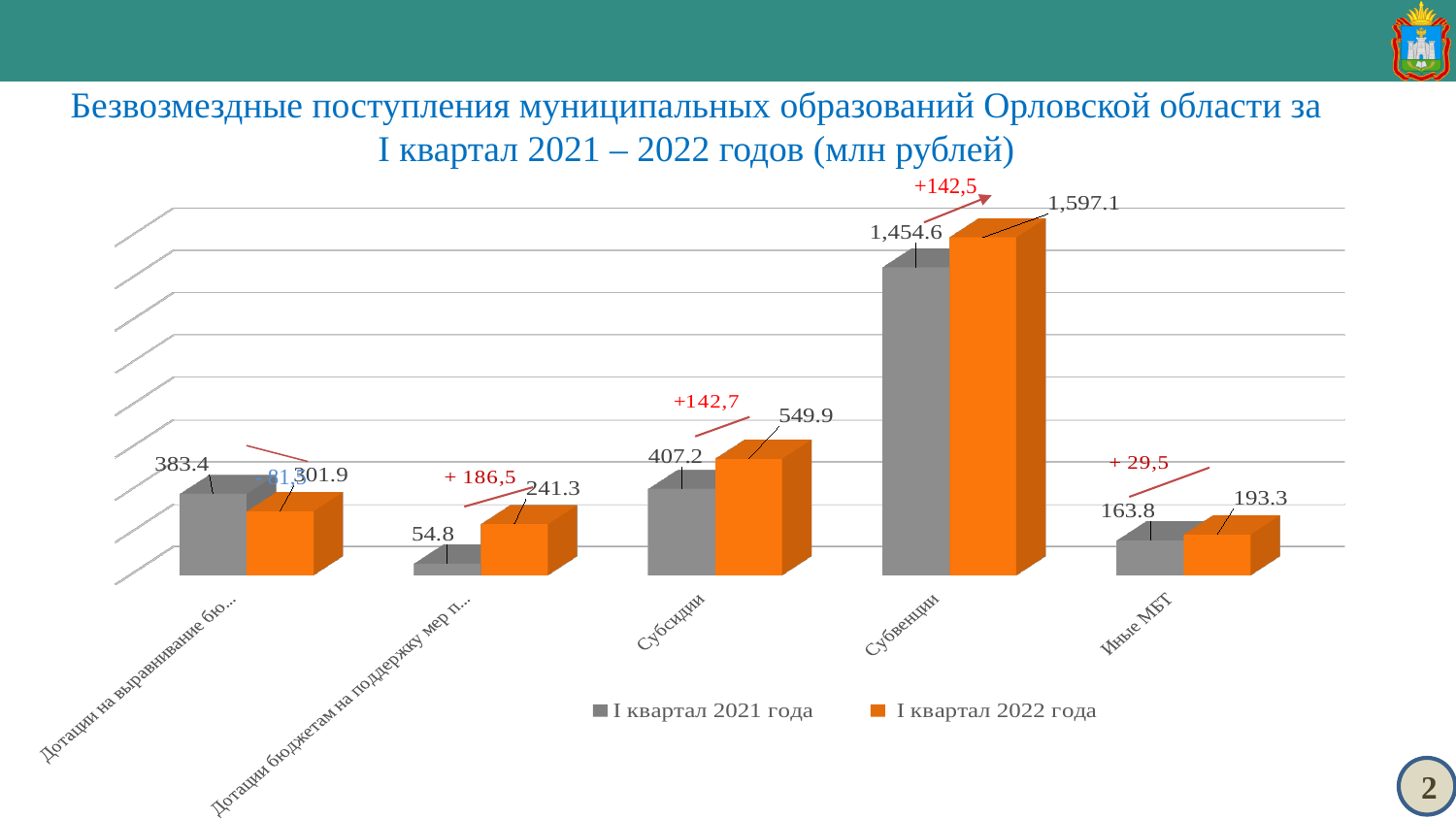
How many series does the legend list? 2 What is the value for Субсидии in I квартал 2021 года? 407.2 What kind of chart is shown on the slide? Bar chart What is the difference between the I квартал 2022 года and I квартал 2021 года values for Иные МБТ? 29.5 Which category has the lowest value for I квартал 2022 года? Иные МБТ How many categories are shown on the x axis of the chart? 5 What is the value for Иные МБТ in I квартал 2021 года? 163.8 What is the difference between the I квартал 2022 года and I квартал 2021 года values for Субвенции? 142.5 What is the value for Субсидии in I квартал 2022 года? 549.9 Which category has the highest value for I квартал 2022 года? Субвенции What is the value for Субвенции in I квартал 2022 года? 1,597.1 Which is larger in I квартал 2022 года: Субсидии or Иные МБТ? Субсидии